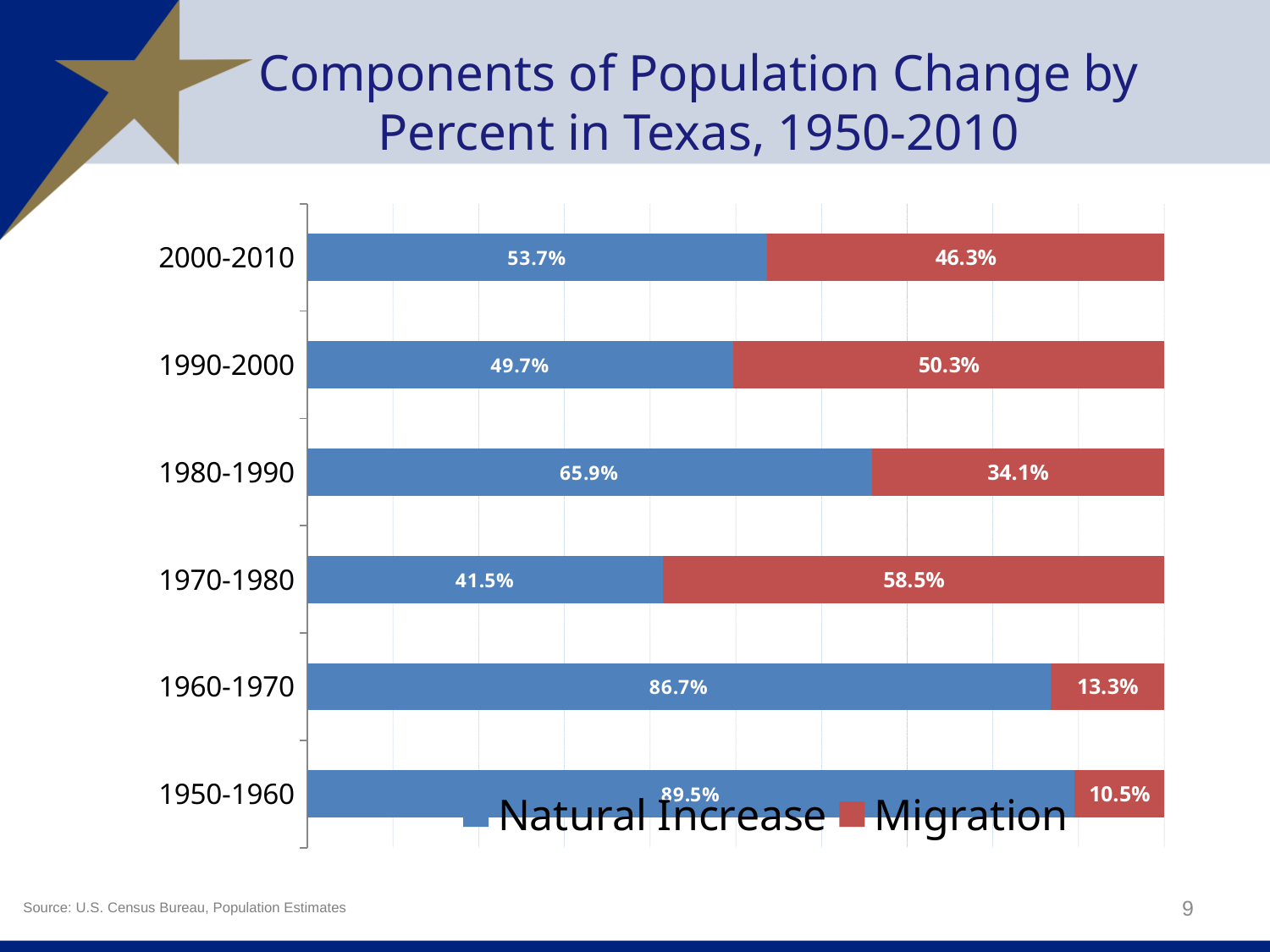
Which period has the lowest Migration share? 1950-1960 How many series does the legend list? 2 What is the Natural Increase value for 2000-2010? 53.7% What is the difference between the Natural Increase and Migration values for 1980-1990? 31.8% Which is larger for 1990-2000, Natural Increase or Migration? Migration Which period has the highest Migration share? 1970-1980 What kind of chart is shown on the slide? Stacked bar chart What is the Migration value for 1950-1960? 10.5% What is the total of the stacked bar for 1960-1970? 100% How many time periods are shown on the chart? 6 What is the Migration value for 1970-1980? 58.5% Which period has the highest Natural Increase share? 1950-1960